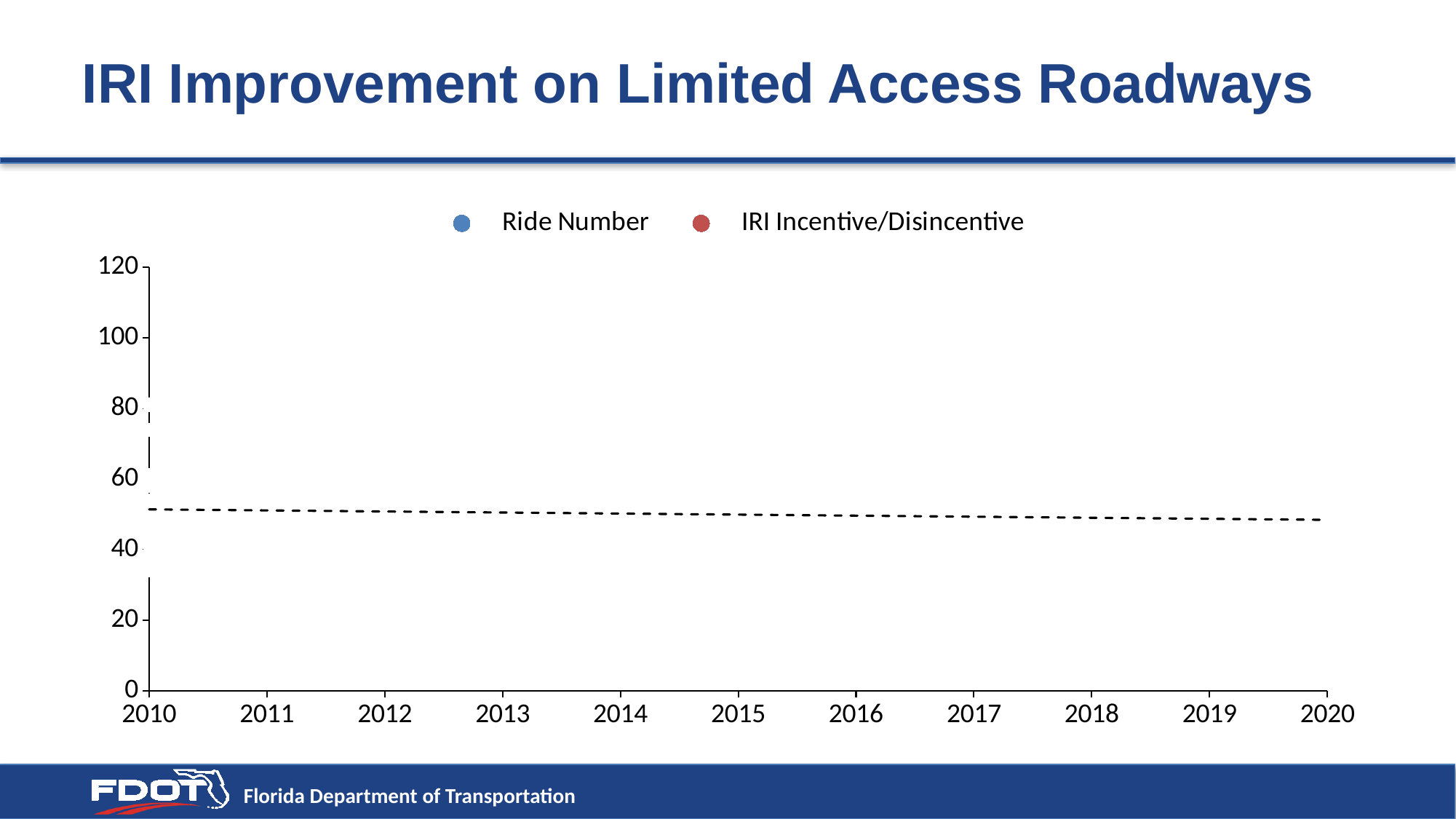
What is the title of the chart? IRI Improvement on Limited Access Roadways What are the two series named in the legend? Ride Number and IRI Incentive/Disincentive How many years are labelled on the x axis? 11 Is the dashed trend line greater or less than 40 across the chart? greater What is the first year shown on the x axis? 2010 How many series does the legend list? 2 Is the dashed trend line greater or less than 60 across the chart? less What is the last year shown on the x axis? 2020 Does the dashed trend line rise or fall from 2010 to 2020? fall What is the highest value labelled on the y axis? 120